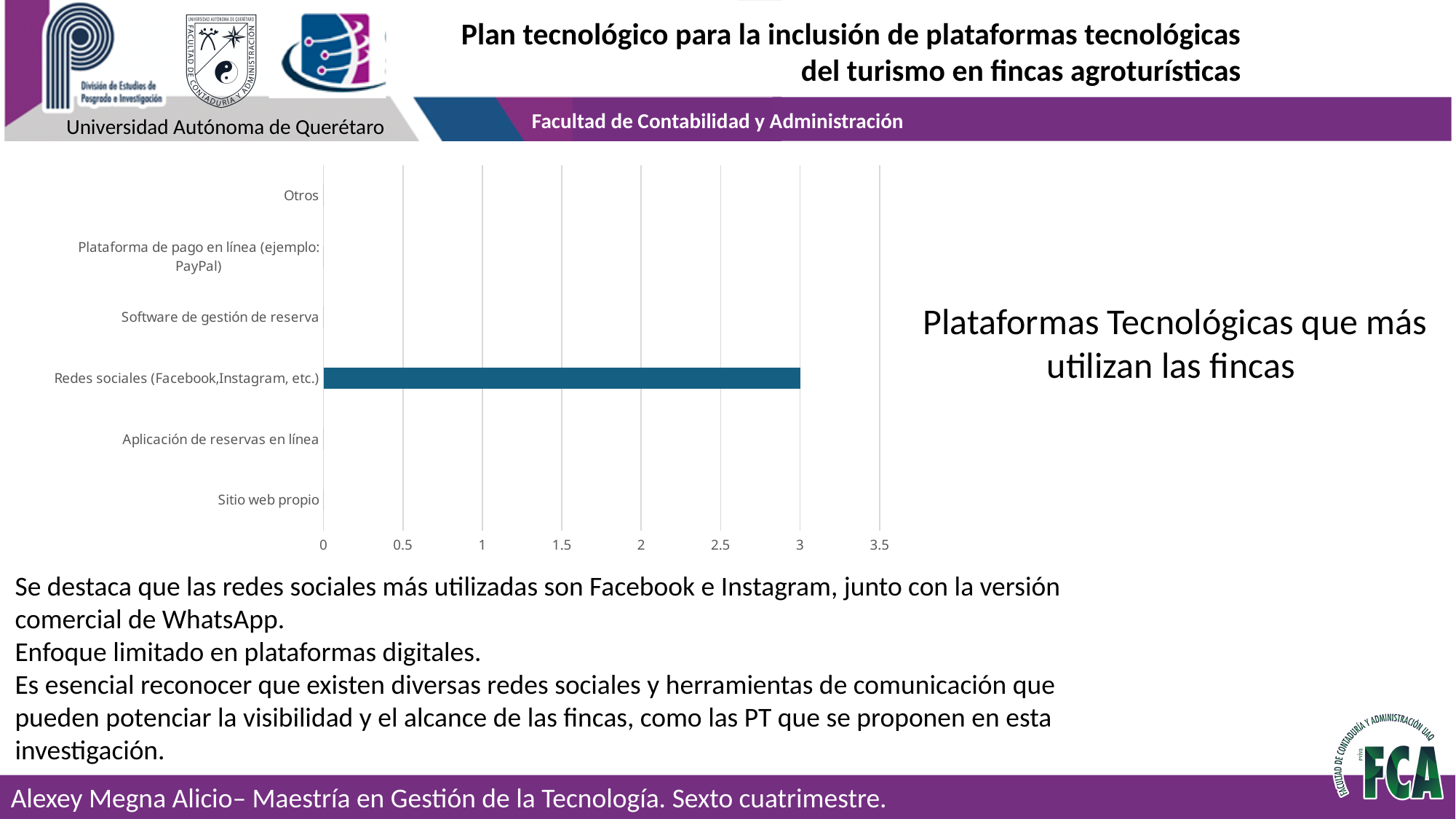
Which category appears at the bottom of the vertical axis? Sitio web propio What kind of chart is shown on the slide? bar chart Which category has the highest value? Redes sociales (Facebook,Instagram, etc.) Which category appears at the top of the vertical axis? Otros What is the value for Redes sociales (Facebook,Instagram, etc.)? 3 What is the highest tick value shown on the horizontal axis? 3.5 Which is larger, the value for Redes sociales (Facebook,Instagram, etc.) or the value for Sitio web propio? Redes sociales (Facebook,Instagram, etc.) Is the value for Redes sociales (Facebook,Instagram, etc.) greater or less than 3.5? less How many categories in the chart have a visible bar? 1 Is the value for Redes sociales (Facebook,Instagram, etc.) greater or less than 2? greater What is the title shown next to the chart? Plataformas Tecnológicas que más utilizan las fincas How many categories are listed on the vertical axis of the chart? 6